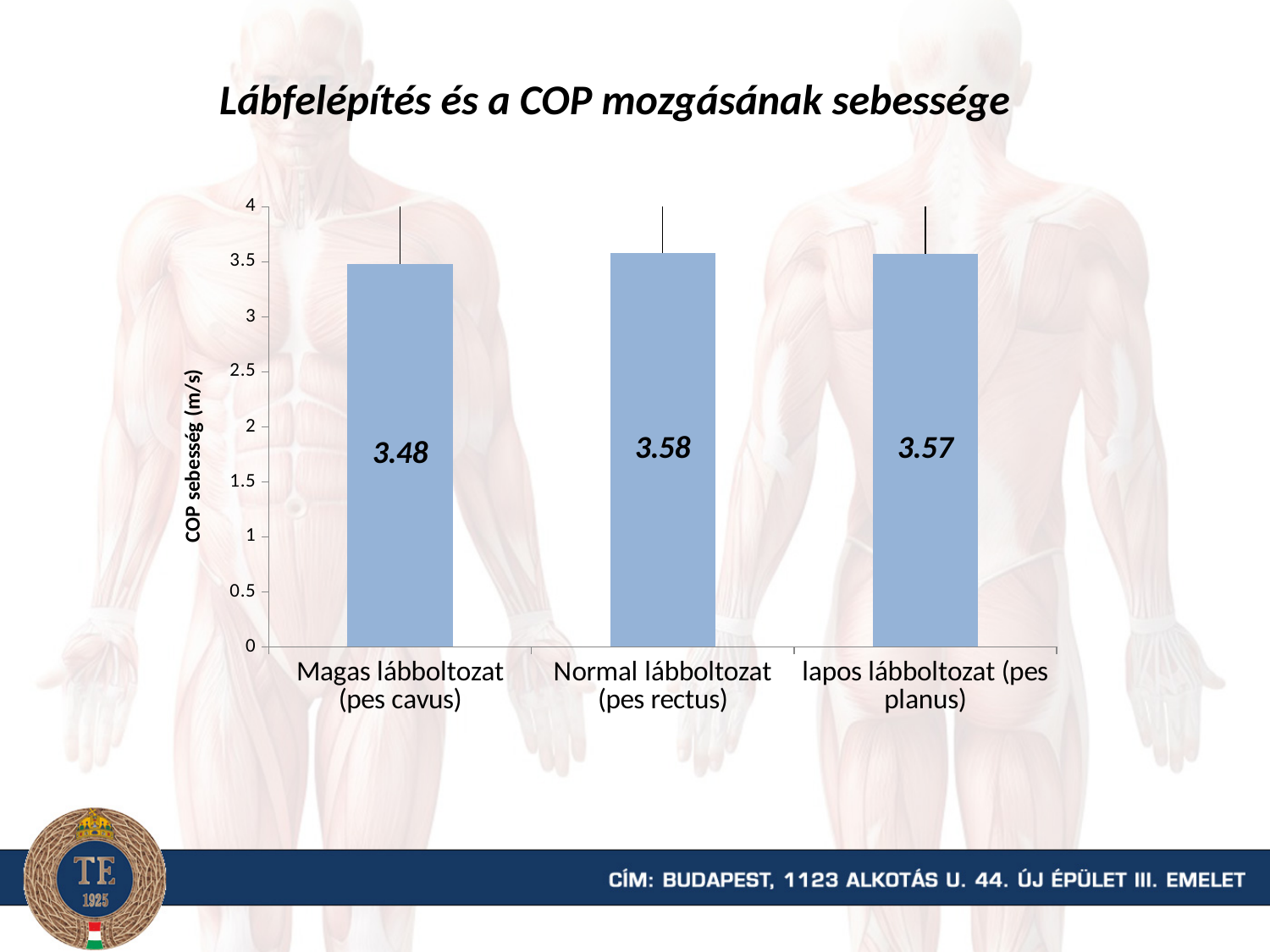
What is the COP speed value for lapos lábboltozat (pes planus)? 3.57 How many foot types are shown in the chart? 3 Which is larger, the COP speed for Magas lábboltozat (pes cavus) or for Normal lábboltozat (pes rectus)? Normal lábboltozat (pes rectus) What is the COP speed value for Magas lábboltozat (pes cavus)? 3.48 What is the label of the vertical axis? COP sebesség (m/s) Is the value for Magas lábboltozat (pes cavus) greater or less than 3? greater Which foot type has the lowest COP speed? Magas lábboltozat (pes cavus) What is the COP speed value for Normal lábboltozat (pes rectus)? 3.58 What is the difference between the COP speed for Normal lábboltozat (pes rectus) and Magas lábboltozat (pes cavus)? 0.10 What kind of chart is shown on the slide? bar chart What is the difference between the COP speed for lapos lábboltozat (pes planus) and Magas lábboltozat (pes cavus)? 0.09 Which foot type has the highest COP speed? Normal lábboltozat (pes rectus)